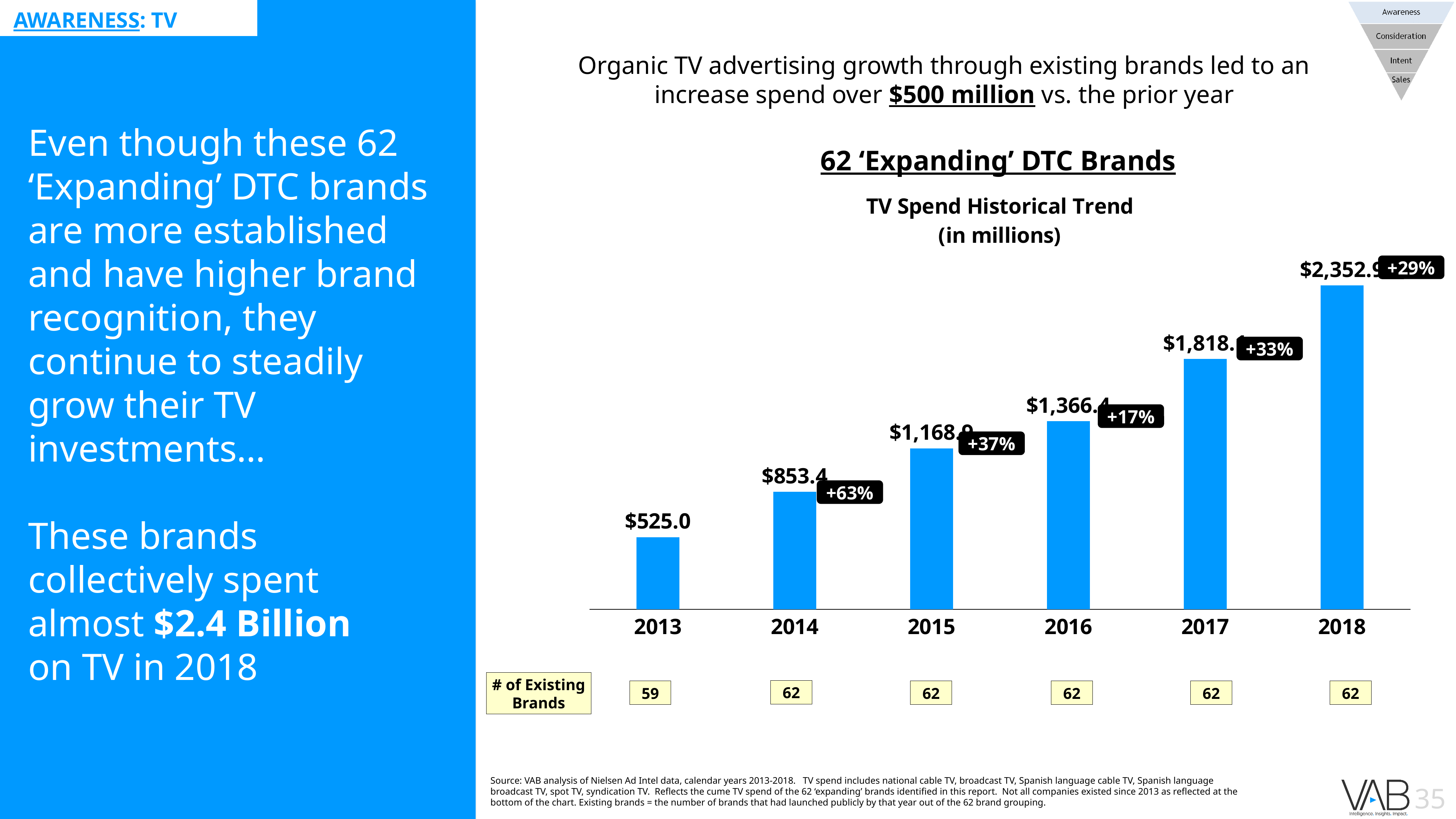
What was the TV spend in 2013? $525.0 Which year has the highest TV spend? 2018 Do the TV spend values rise or fall from 2013 to 2018? rise Which year shows the smallest year-over-year growth percentage? 2016 How many existing brands are shown for 2013? 59 What year-over-year growth percentage is shown for 2014? +63% What kind of chart is shown on the slide? bar chart How many years are plotted in the TV Spend Historical Trend chart? 6 Which year has the lowest TV spend? 2013 What was the TV spend in 2014? $853.4 What is the difference in TV spend between 2014 and 2013? $328.4 In what units are the TV spend values expressed, according to the chart subtitle? in millions